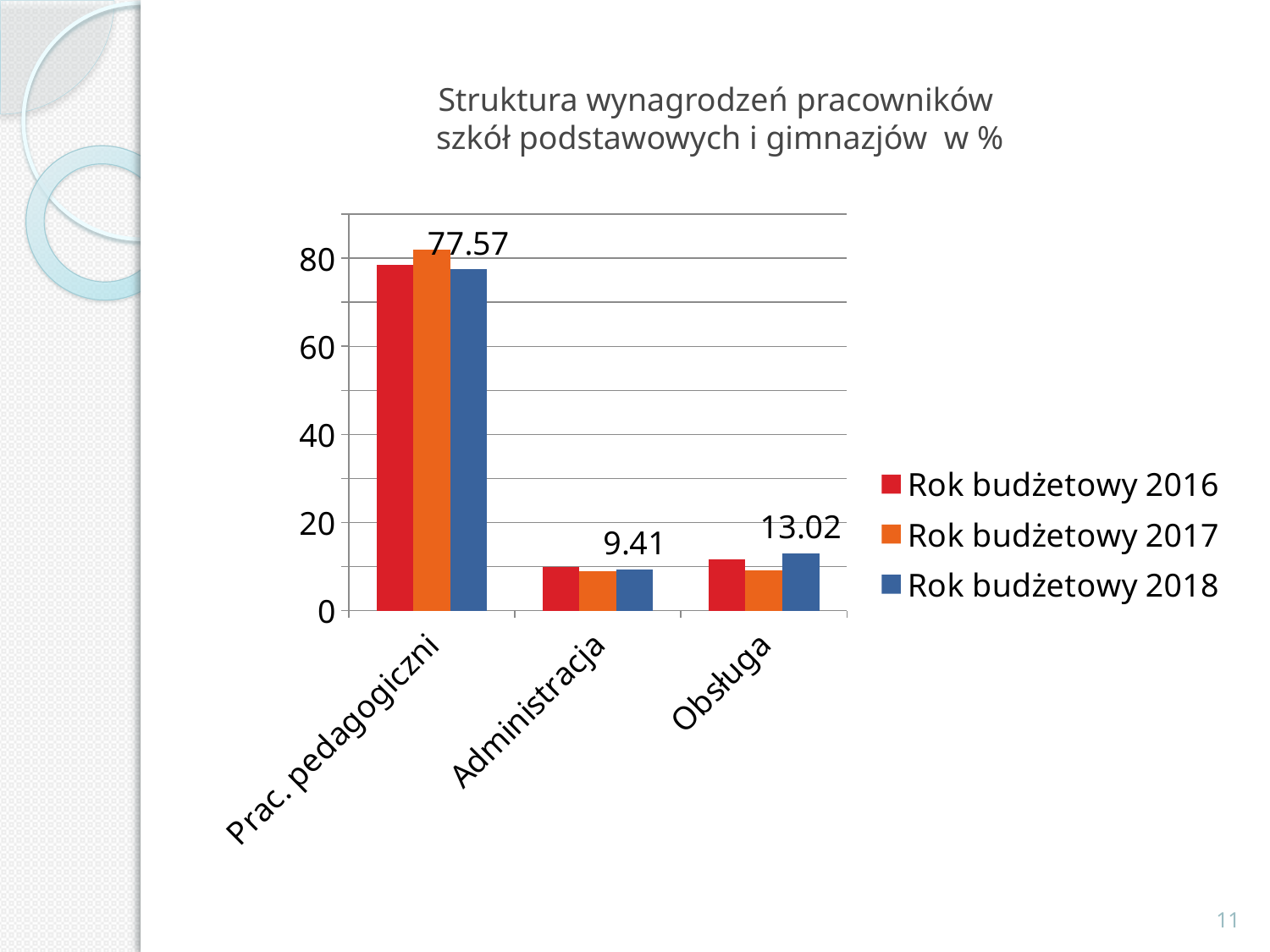
What is the difference between the Rok budżetowy 2018 values for Obsługa and Administracja? 3.61 Which category has the lowest value in the Rok budżetowy 2018 series? Administracja Which category has the highest value in the Rok budżetowy 2018 series? Prac. pedagogiczni What is the value for Prac. pedagogiczni in the Rok budżetowy 2018 series? 77.57 Is the value for Prac. pedagogiczni in the Rok budżetowy 2016 series greater or less than 60? greater In the Rok budżetowy 2018 series, which is larger: Obsługa or Administracja? Obsługa What is the value for Obsługa in the Rok budżetowy 2018 series? 13.02 What is the value for Administracja in the Rok budżetowy 2018 series? 9.41 What kind of chart is shown on the slide? bar chart Which series is shown in blue in the legend? Rok budżetowy 2018 How many series does the legend list? 3 How many categories are shown on the x axis? 3